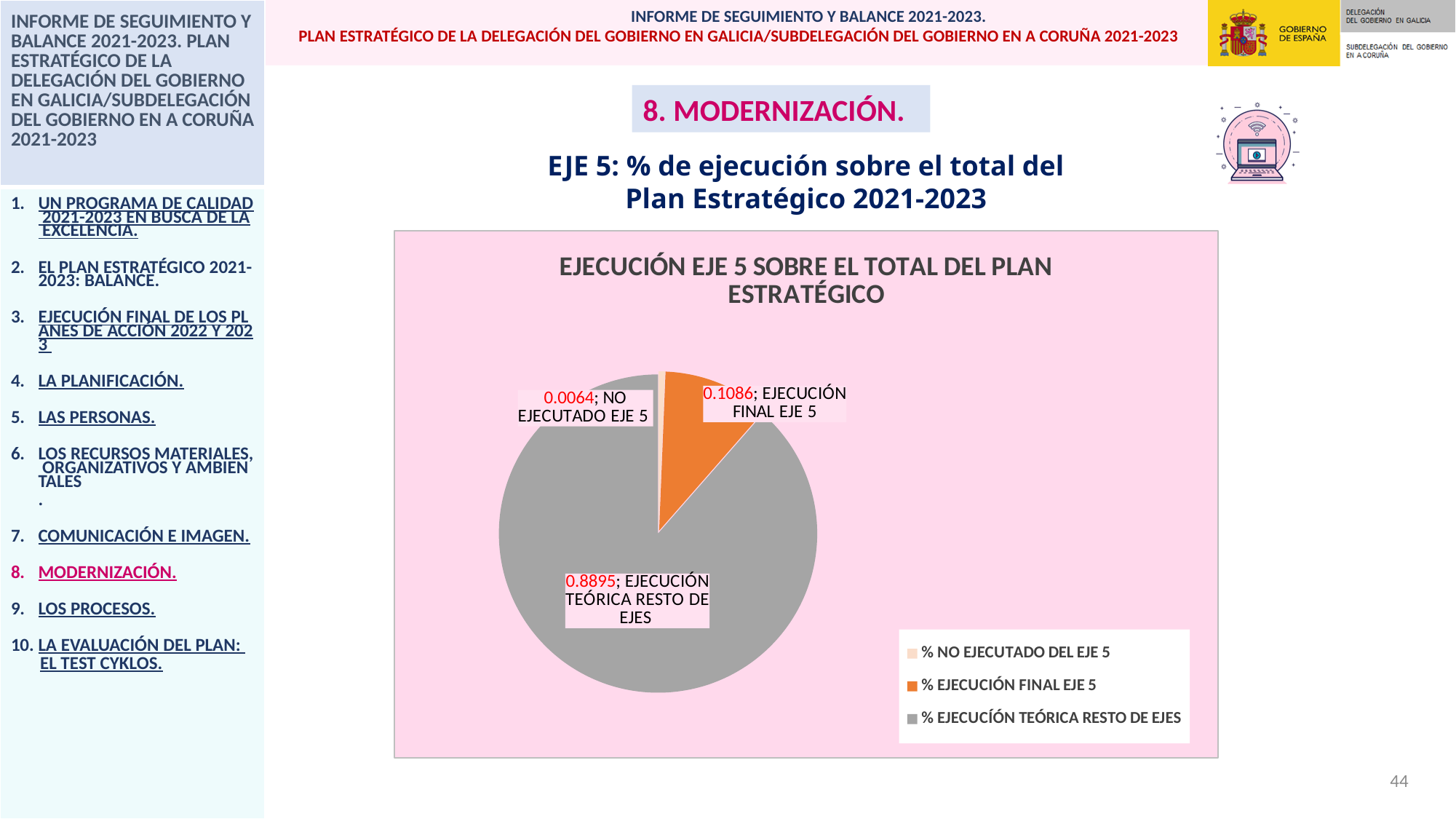
What is the title of the chart? EJECUCIÓN EJE 5 SOBRE EL TOTAL DEL PLAN ESTRATÉGICO What is the difference between the values for EJECUCIÓN FINAL EJE 5 and NO EJECUTADO EJE 5? 0.1022 How many slices does the pie chart have? 3 Which is larger, EJECUCIÓN FINAL EJE 5 or NO EJECUTADO EJE 5? EJECUCIÓN FINAL EJE 5 What colour is the slice for % EJECUCIÓN FINAL EJE 5? Orange What is the value shown for EJECUCIÓN TEÓRICA RESTO DE EJES? 0.8895 Which slice of the pie chart is the largest? EJECUCIÓN TEÓRICA RESTO DE EJES What is the value shown for NO EJECUTADO EJE 5? 0.0064 What is the value shown for EJECUCIÓN FINAL EJE 5? 0.1086 What kind of chart is shown on the slide? Pie chart How many entries does the legend list? 3 Which slice of the pie chart is the smallest? NO EJECUTADO EJE 5